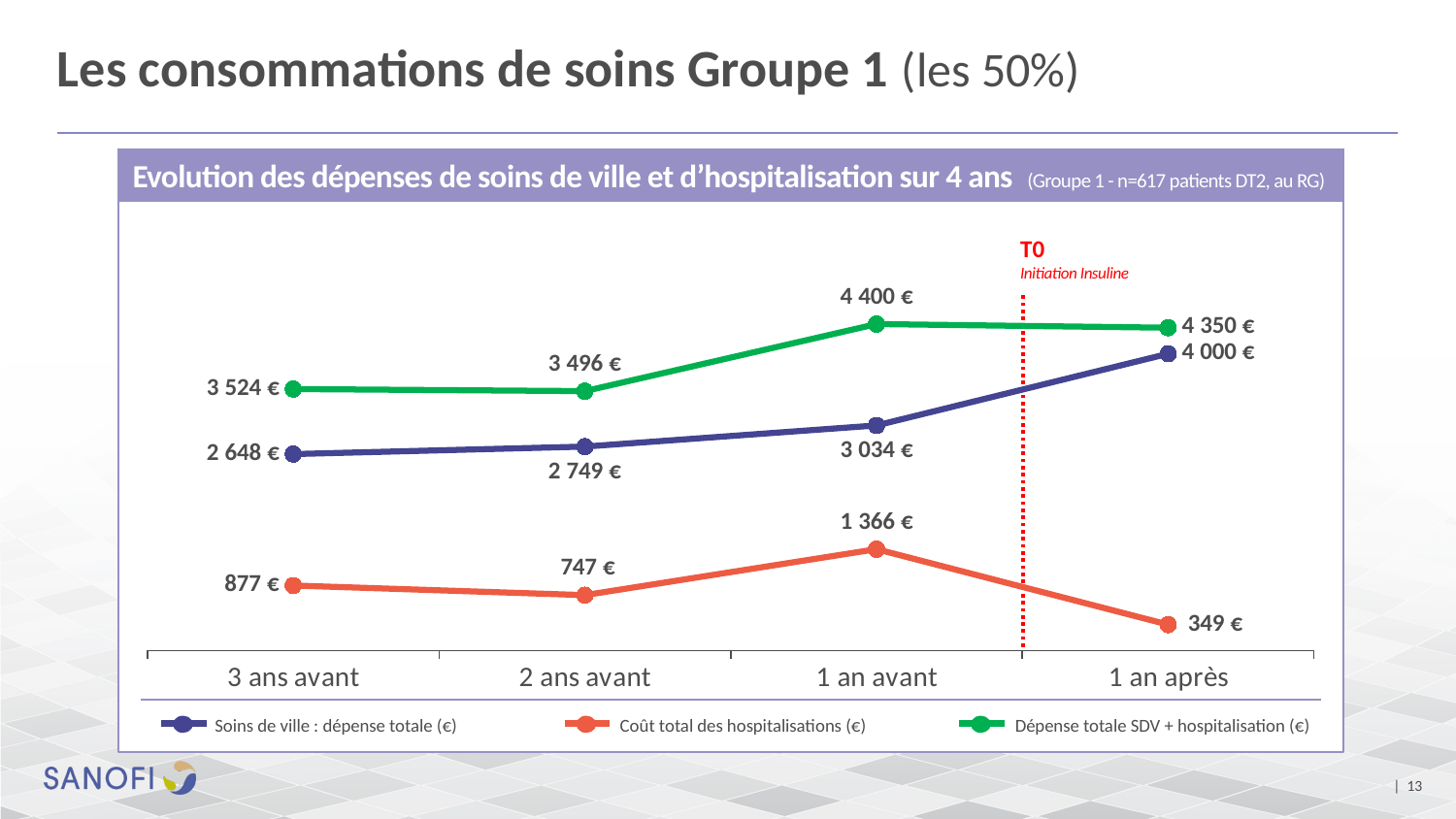
At which time point is 'Dépense totale SDV + hospitalisation (€)' highest? 1 an avant What is the difference between 'Soins de ville : dépense totale (€)' at '1 an après' and at '1 an avant'? 966 € How many series does the legend list? 3 What is the value of 'Soins de ville : dépense totale (€)' at '1 an après'? 4 000 € What event does the red dashed vertical line labelled T0 mark? Initiation Insuline What is the value of 'Coût total des hospitalisations (€)' at '1 an avant'? 1 366 € What is the value of 'Dépense totale SDV + hospitalisation (€)' at '3 ans avant'? 3 524 € Does 'Soins de ville : dépense totale (€)' rise or fall from '3 ans avant' to '1 an après'? rise At which time point is 'Coût total des hospitalisations (€)' lowest? 1 an après Which is larger: 'Coût total des hospitalisations (€)' at '3 ans avant' or at '2 ans avant'? 3 ans avant What type of chart is shown on the slide? line chart How many time points are plotted along the x axis? 4